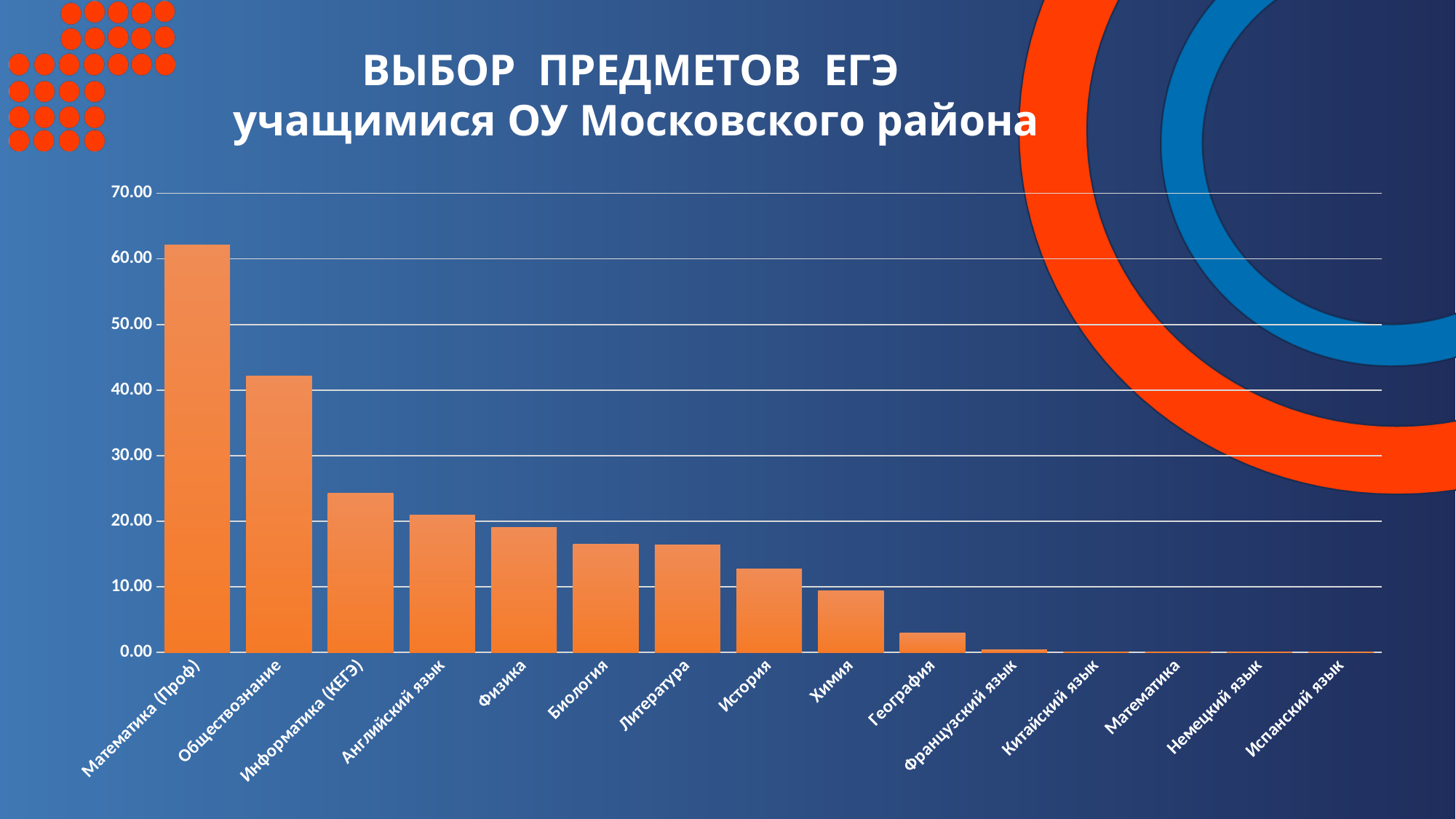
Which subject has the highest bar in the chart? Математика (Проф) What is the title of the slide containing the chart? ВЫБОР ПРЕДМЕТОВ ЕГЭ учащимися ОУ Московского района Is the value for Информатика (КЕГЭ) greater or less than 20? greater What kind of chart is shown on the slide? bar chart How many subjects (categories) are shown on the x axis of the chart? 15 Which has the larger value, Обществознание or Информатика (КЕГЭ)? Обществознание Is the value for Математика (Проф) greater or less than 60? greater Is the value for История greater or less than 10? greater Which has the larger value, Физика or История? Физика Do the bar values rise or fall from left to right along the x axis? fall